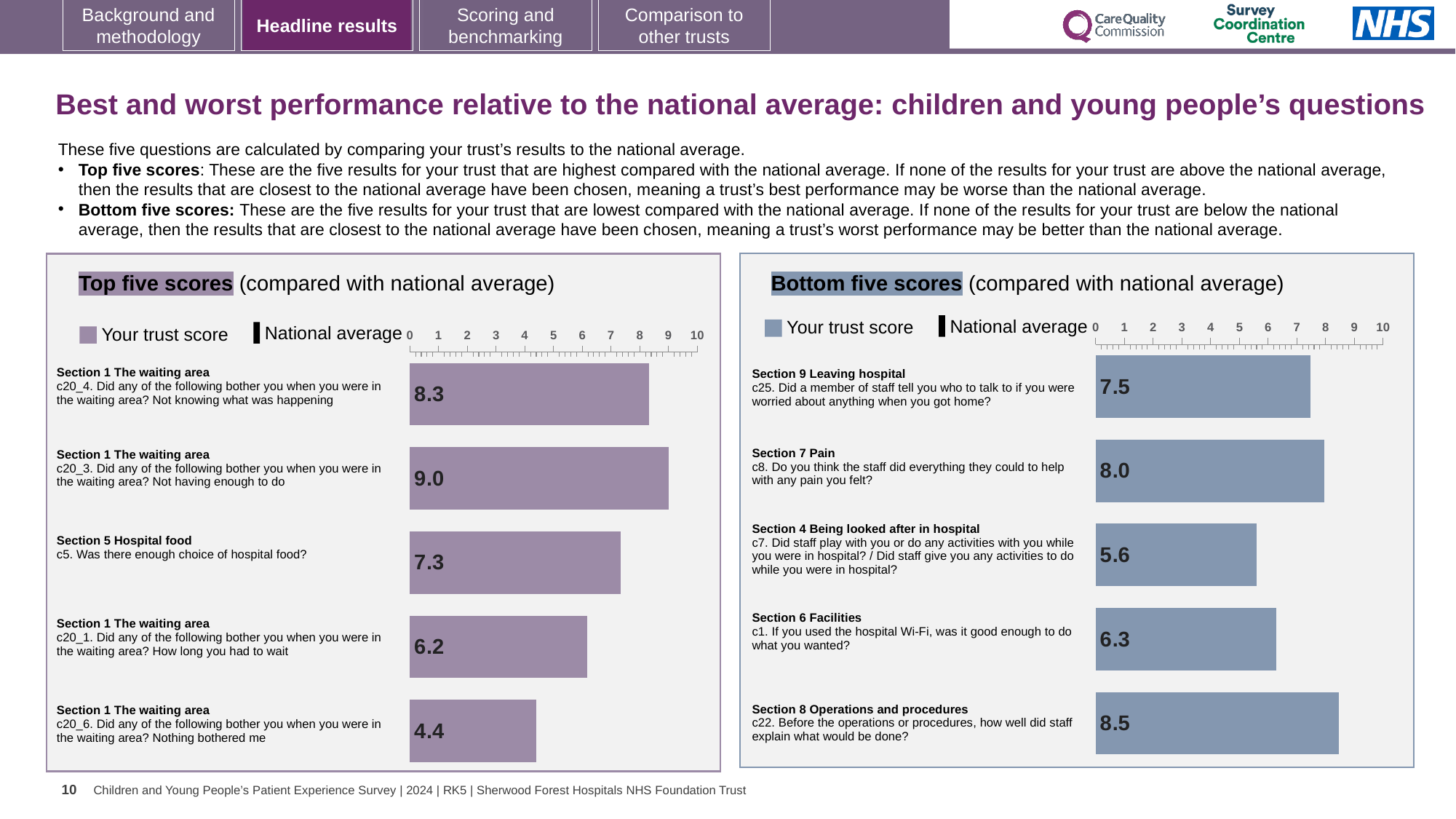
In the Bottom five scores chart, what is the trust score for c7 (Did staff play with you or do any activities with you)? 5.6 In the Top five scores chart, which question has the highest trust score? c20_3. Not having enough to do In the Top five scores chart, what is the trust score for c20_3 (Not having enough to do in the waiting area)? 9.0 What type of chart is the Bottom five scores chart? Bar chart In the Top five scores chart, what is the difference between the trust scores for c20_4 and c20_1? 2.1 In the Bottom five scores chart, what is the trust score for c22 (how well did staff explain what would be done)? 8.5 In the Top five scores chart, which question has the lowest trust score? c20_6. Nothing bothered me In the Bottom five scores chart, which is larger: the trust score for c25 or for c8? c8 How many questions are shown in the Top five scores chart? 5 In the Bottom five scores chart, which question has the highest trust score? c22. Before the operations or procedures, how well did staff explain what would be done? In the Bottom five scores chart, what is the difference between the trust scores for c8 and c1? 1.7 In the Top five scores chart, what is the trust score for c5 (Was there enough choice of hospital food?)? 7.3